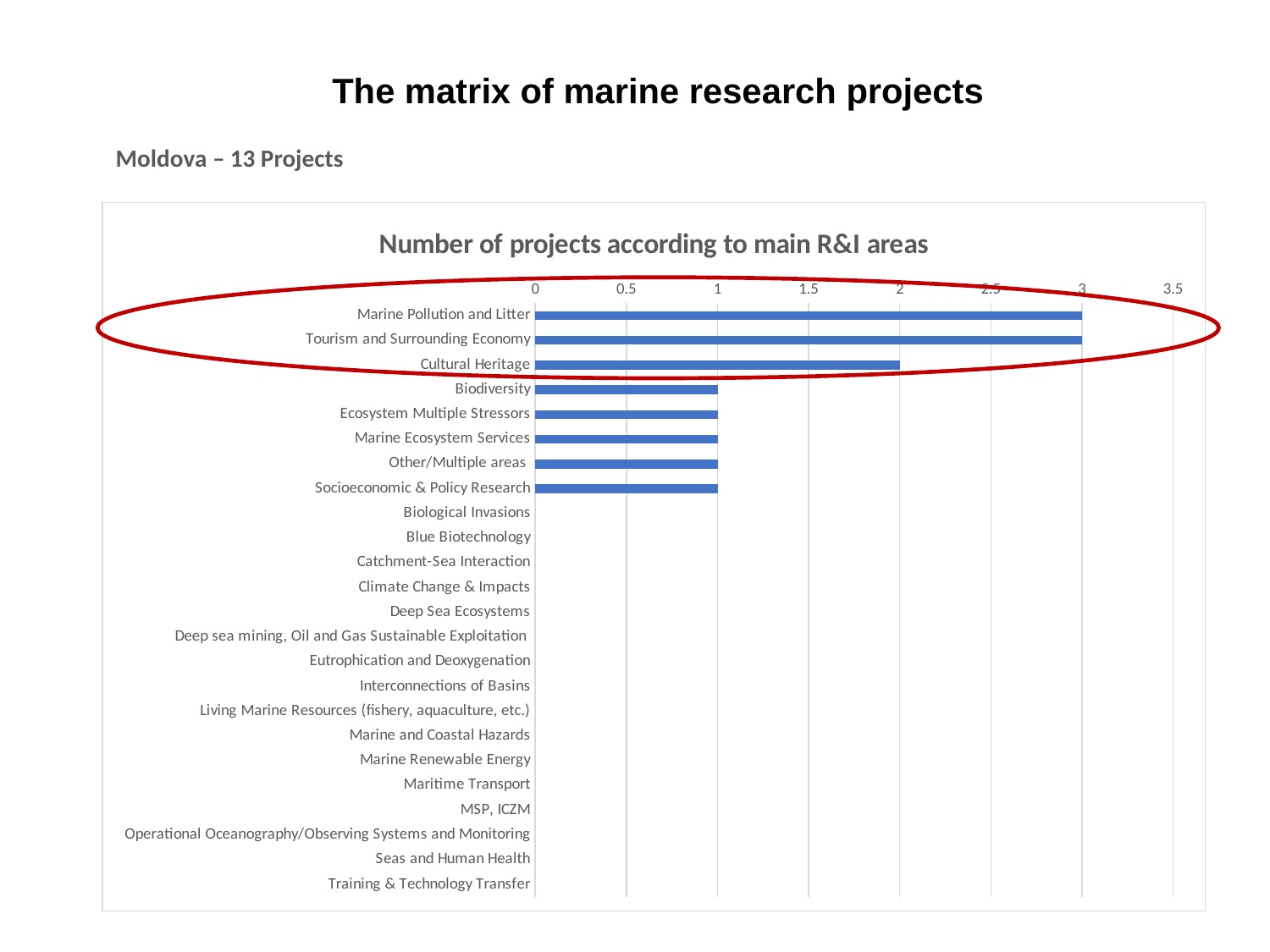
How many projects are shown for Tourism and Surrounding Economy? 3 What is the title of the chart? Number of projects according to main R&I areas What is the difference in the number of projects between Marine Pollution and Litter and Cultural Heritage? 1 How many projects are shown for Cultural Heritage? 2 What is the highest value shown on the horizontal axis of the chart? 3.5 Which two R&I areas have the highest number of projects? Marine Pollution and Litter and Tourism and Surrounding Economy How many projects are shown for Marine Pollution and Litter? 3 How many R&I area categories are listed on the chart's vertical axis? 24 Is the value for Cultural Heritage greater or less than 1.5? greater What type of chart is shown on the slide? bar chart How many projects are shown for Biodiversity? 1 Which has more projects, Cultural Heritage or Socioeconomic & Policy Research? Cultural Heritage